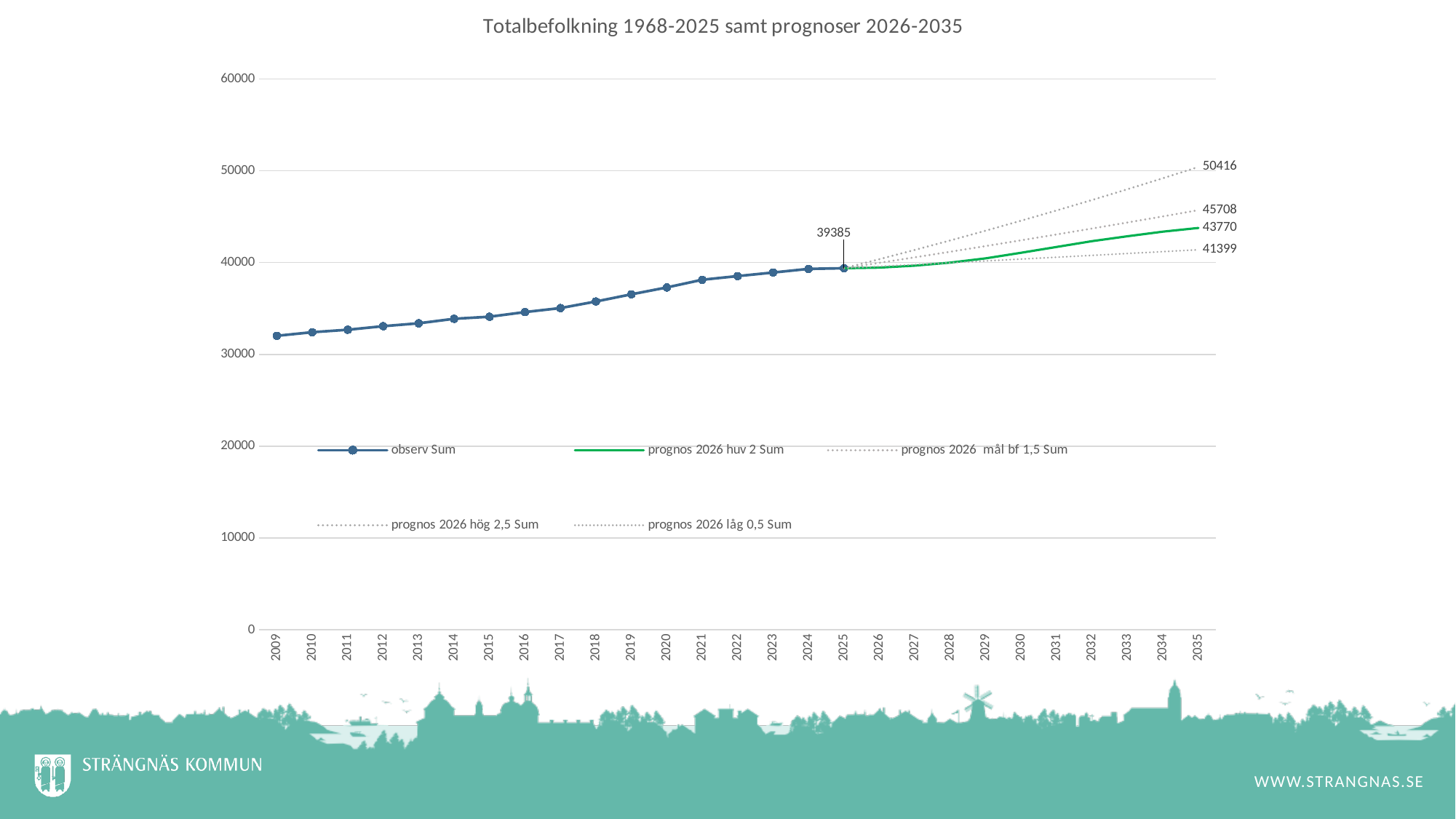
What is the difference between the highest (50416) and lowest (41399) 2035 projection values? 9017 How many series does the legend list? 5 What kind of chart is shown on the slide? line chart What is the title of the chart? Totalbefolkning 1968-2025 samt prognoser 2026-2035 Is the observ Sum value for 2009 greater or less than 30000? greater What is the lowest value labelled at the 2035 end of the projection lines? 41399 What is the highest value labelled at the 2035 end of the projection lines? 50416 What is the difference between the 2035 values labelled 45708 and 43770? 1938 How much higher is the 2035 value of the green prognos 2026 huv 2 Sum line (43770) than the 2025 observed value (39385)? 4385 What is the labelled value of the observ Sum series in 2025? 39385 Does the observ Sum series rise or fall from 2009 to 2025? rise What value does the green prognos 2026 huv 2 Sum line reach in 2035? 43770